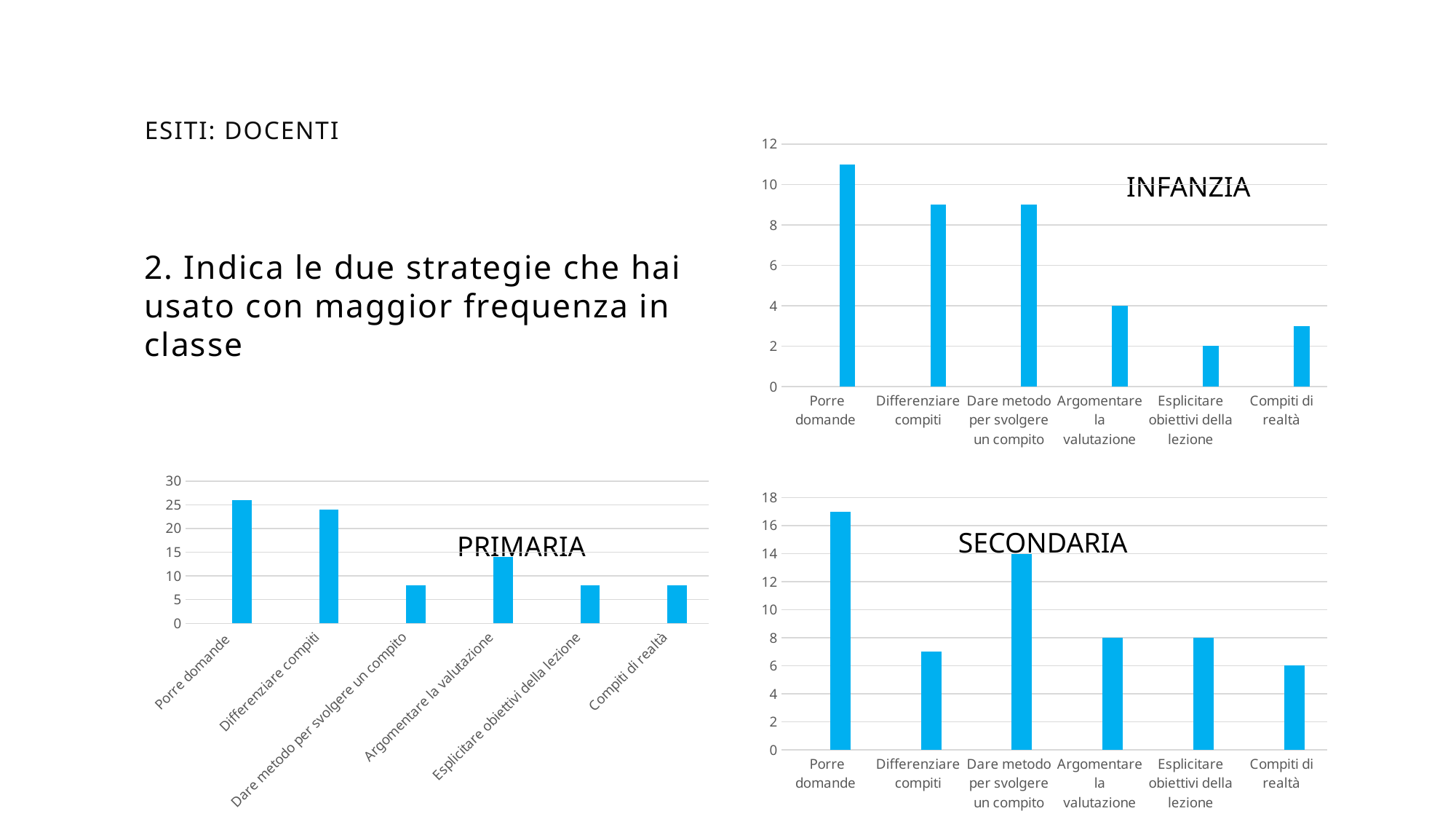
On the INFANZIA chart, what is the value for Esplicitare obiettivi della lezione? 2 On the SECONDARIA chart, which category has the highest value? Porre domande What type of chart is the INFANZIA chart? bar chart On the PRIMARIA chart, is the value for Porre domande greater or less than 20? greater On the INFANZIA chart, what is the value for Argomentare la valutazione? 4 On the SECONDARIA chart, what is the difference between Dare metodo per svolgere un compito and Compiti di realtà? 8 On the INFANZIA chart, which category has the highest value? Porre domande On the SECONDARIA chart, what is the value for Argomentare la valutazione? 8 On the SECONDARIA chart, what is the value for Compiti di realtà? 6 How many categories are shown on the PRIMARIA chart? 6 On the SECONDARIA chart, what is the value for Dare metodo per svolgere un compito? 14 On the SECONDARIA chart, which is larger, Porre domande or Differenziare compiti? Porre domande